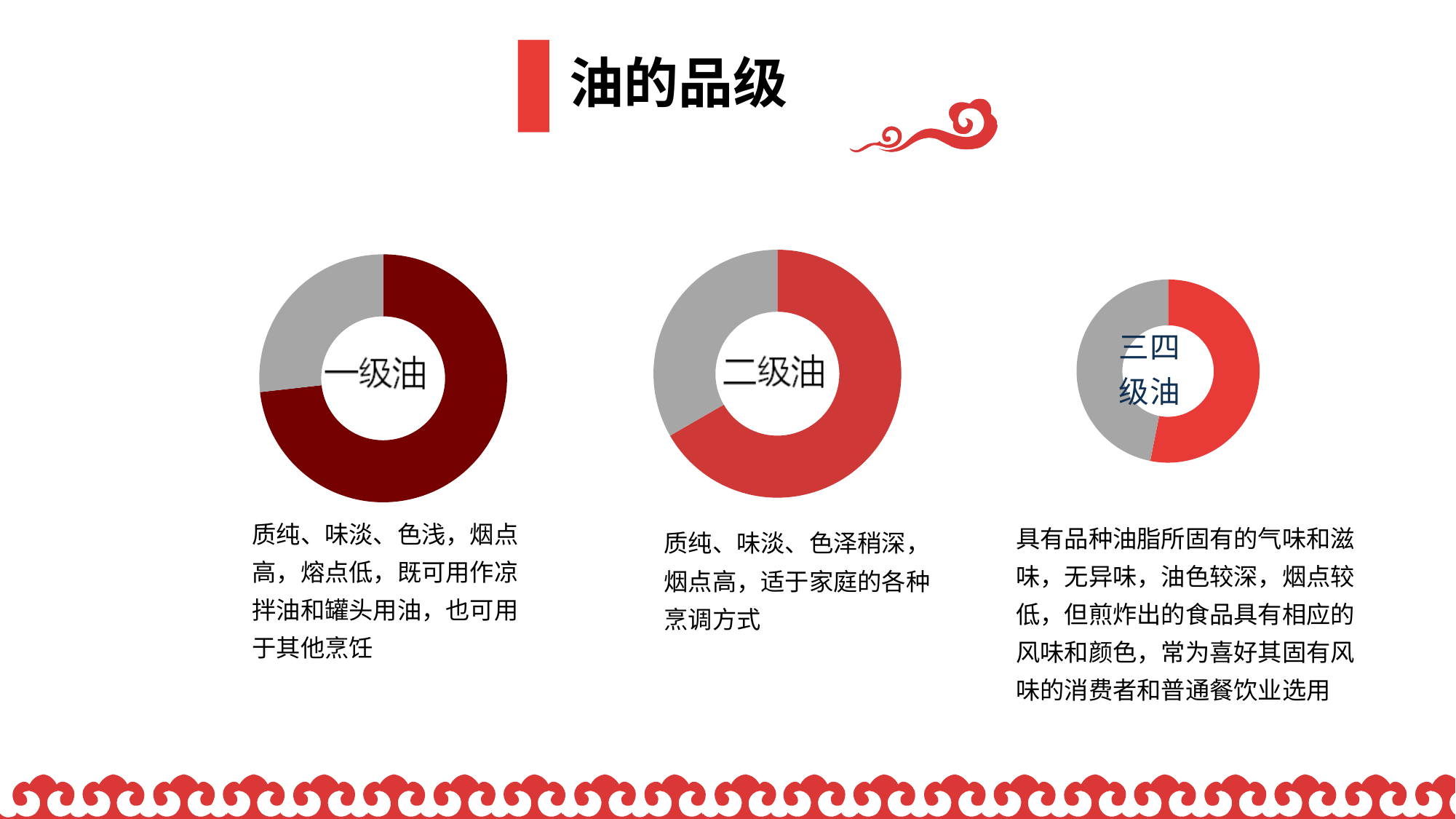
What label is printed in the centre of the rightmost chart? 三四级油 In the 二级油 chart, which slice is larger, the red one or the grey one? the red one In the 一级油 chart, which slice is larger, the dark red one or the grey one? the dark red one What label is printed in the centre of the middle chart? 二级油 How many slices does the 一级油 chart have? 2 How many slices does the 二级油 chart have? 2 How many slices does the 三四级油 chart have? 2 What kind of chart is the 一级油 chart on the left? doughnut (pie) chart